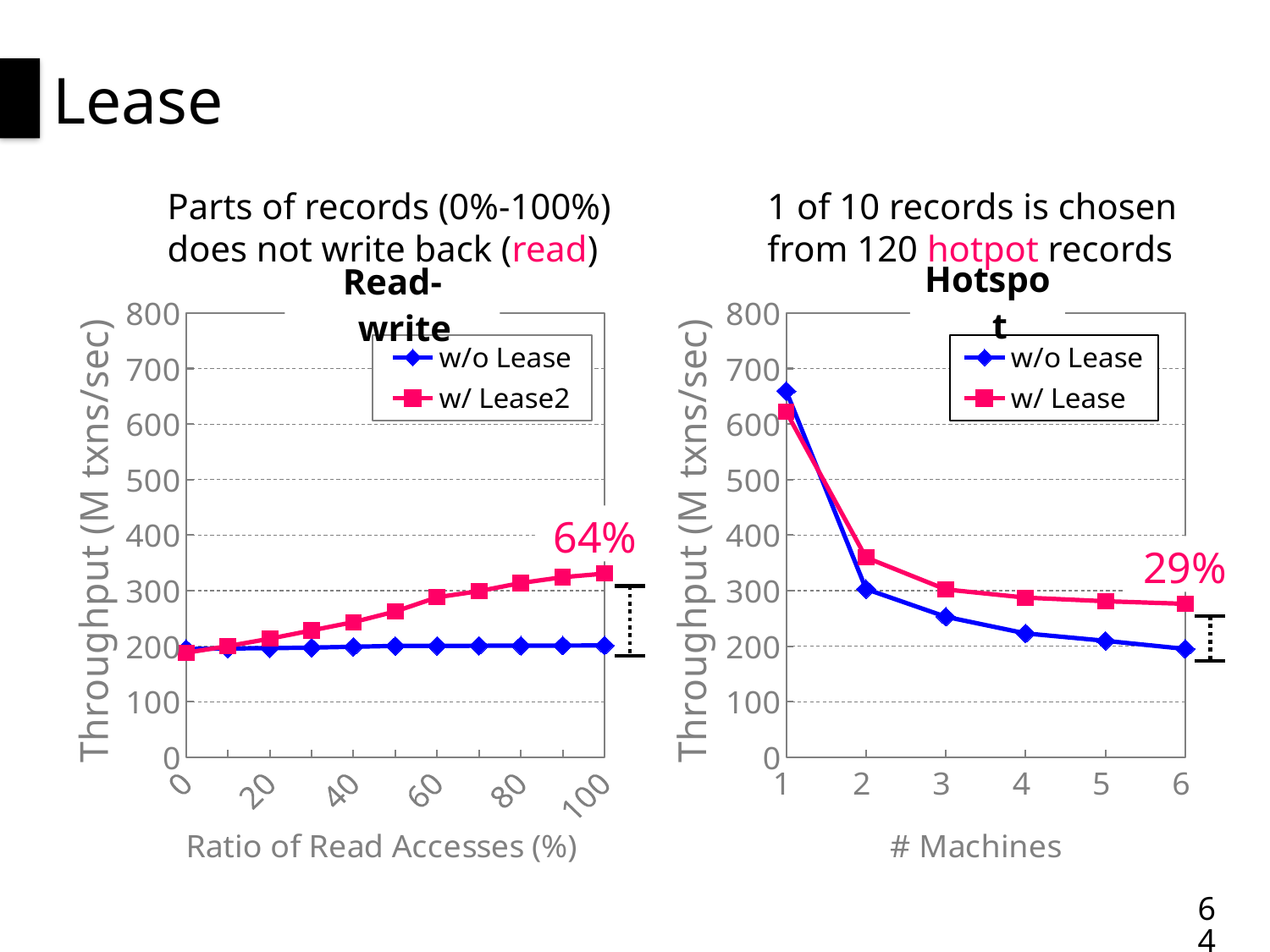
In the Hotspot chart, is the w/ Lease value at 6 machines greater or less than 300? less In the Read-write chart, does the w/ Lease2 series rise or fall as the ratio of read accesses increases? rise How many series does the legend of the Hotspot chart on the right list? 2 In the Hotspot chart, is the w/o Lease value at 1 machine greater or less than 600? greater In the Hotspot chart, does the w/o Lease series rise or fall as the number of machines increases? fall What type of chart is the Read-write chart on the left? line chart In the Hotspot chart, how many machine counts are plotted along the x axis? 6 What is the x-axis label of the Hotspot chart? # Machines In the Read-write chart, which series is higher at 100% read accesses, w/o Lease or w/ Lease2? w/ Lease2 In the Read-write chart, how many x-axis points are plotted for each series? 11 In the Read-write chart, is the w/ Lease2 value at 100% read accesses greater or less than 300? greater In the Hotspot chart, at which number of machines is the w/o Lease throughput highest? 1